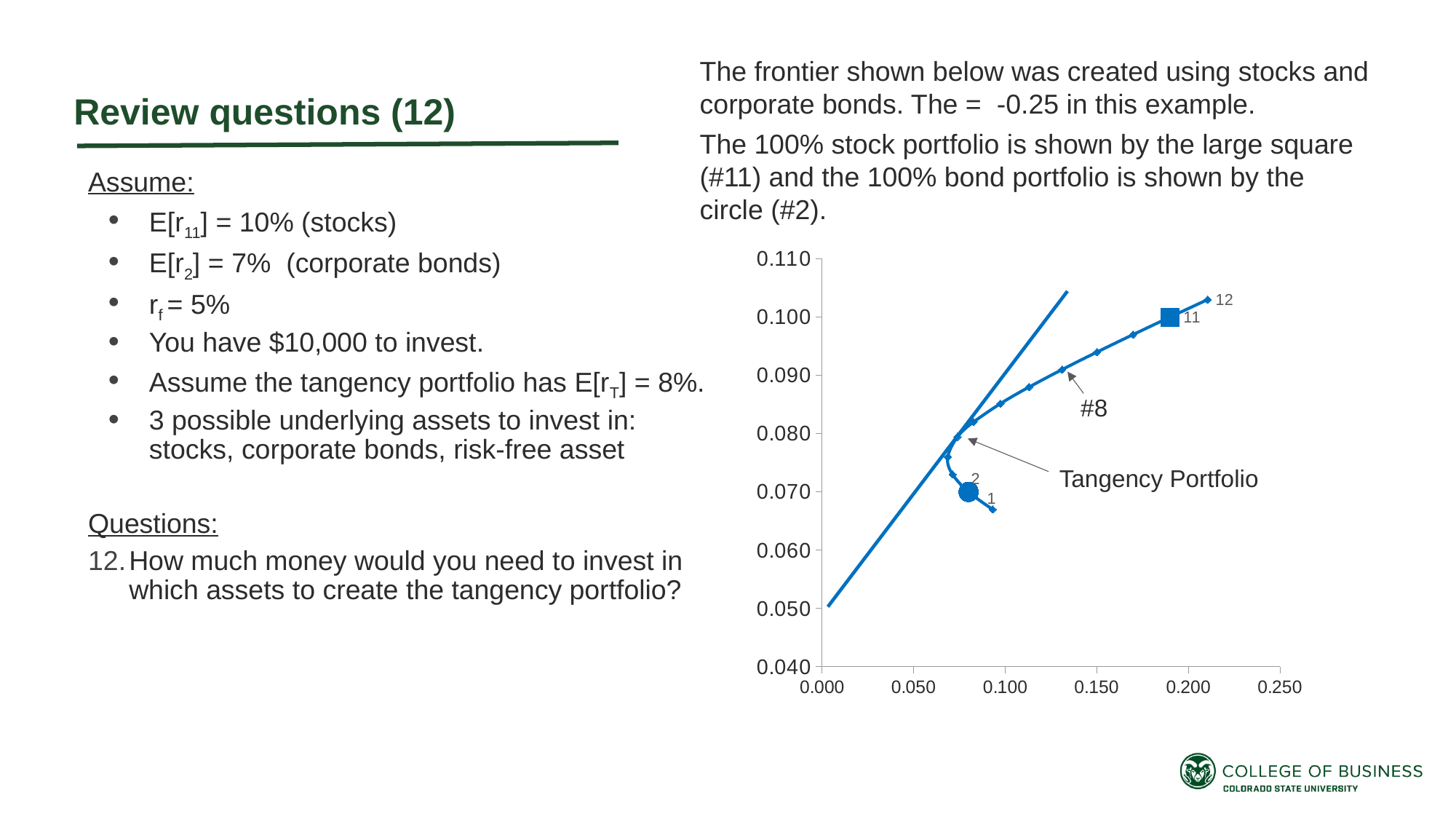
What is the difference between the y-axis values of point 11 and point 2? 0.030 Is the x-axis value of the point labeled #8 greater or less than 0.100? greater At what y-axis value does the straight line start on the left edge of the chart? 0.050 Which labeled point on the frontier has the highest y-axis value? 12 What is the y-axis value of point 11 (the large square)? 0.100 Which has the higher y-axis value, point 11 or point 2? point 11 Is the x-axis value of point 12 greater or less than 0.200? greater What is the highest tick value shown on the y-axis? 0.110 What kind of chart is shown on the slide? scatter chart What is the y-axis value of point 2 (the circle)? 0.070 Is the x-axis value of the Tangency Portfolio greater or less than 0.100? less Which labeled point on the frontier has the lowest y-axis value? 1